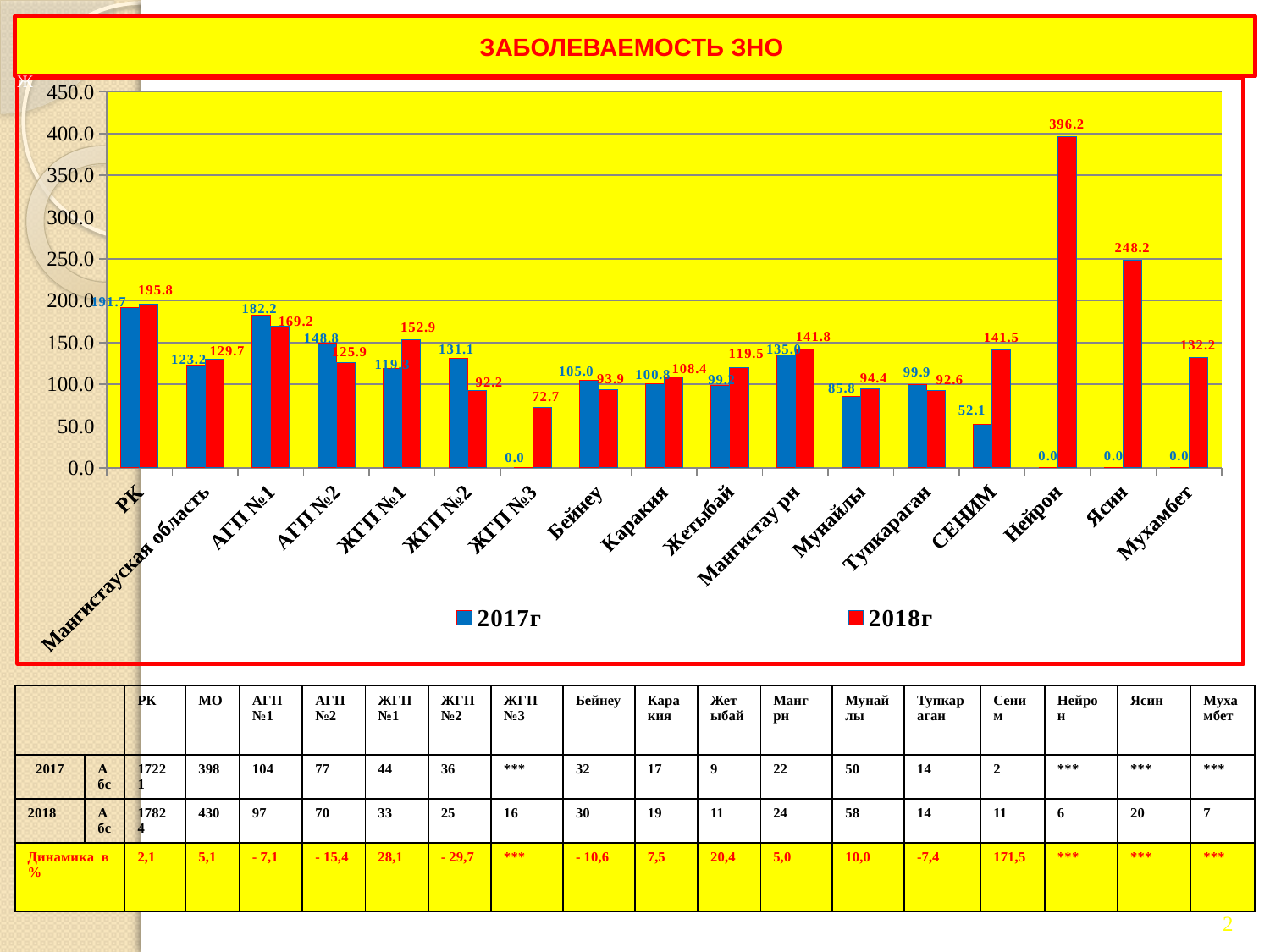
Which category has the highest value in the 2017г series? РК What is the value for РК in the 2017г series? 191.7 Which category has the highest value in the 2018г series? Нейрон What is the value for Нейрон in the 2018г series? 396.2 What is the value for ЖГП №2 in the 2017г series? 131.1 Which is larger for АГП №1: the 2017г value or the 2018г value? 2017г Is the 2018г value for Ясин greater or less than 200.0? greater What is the value for СЕНИМ in the 2018г series? 141.5 How many categories are shown on the x axis? 17 What is the difference between the 2018г and 2017г values for СЕНИМ? 89.4 How many series does the legend list? 2 What kind of chart is shown on the slide? bar chart